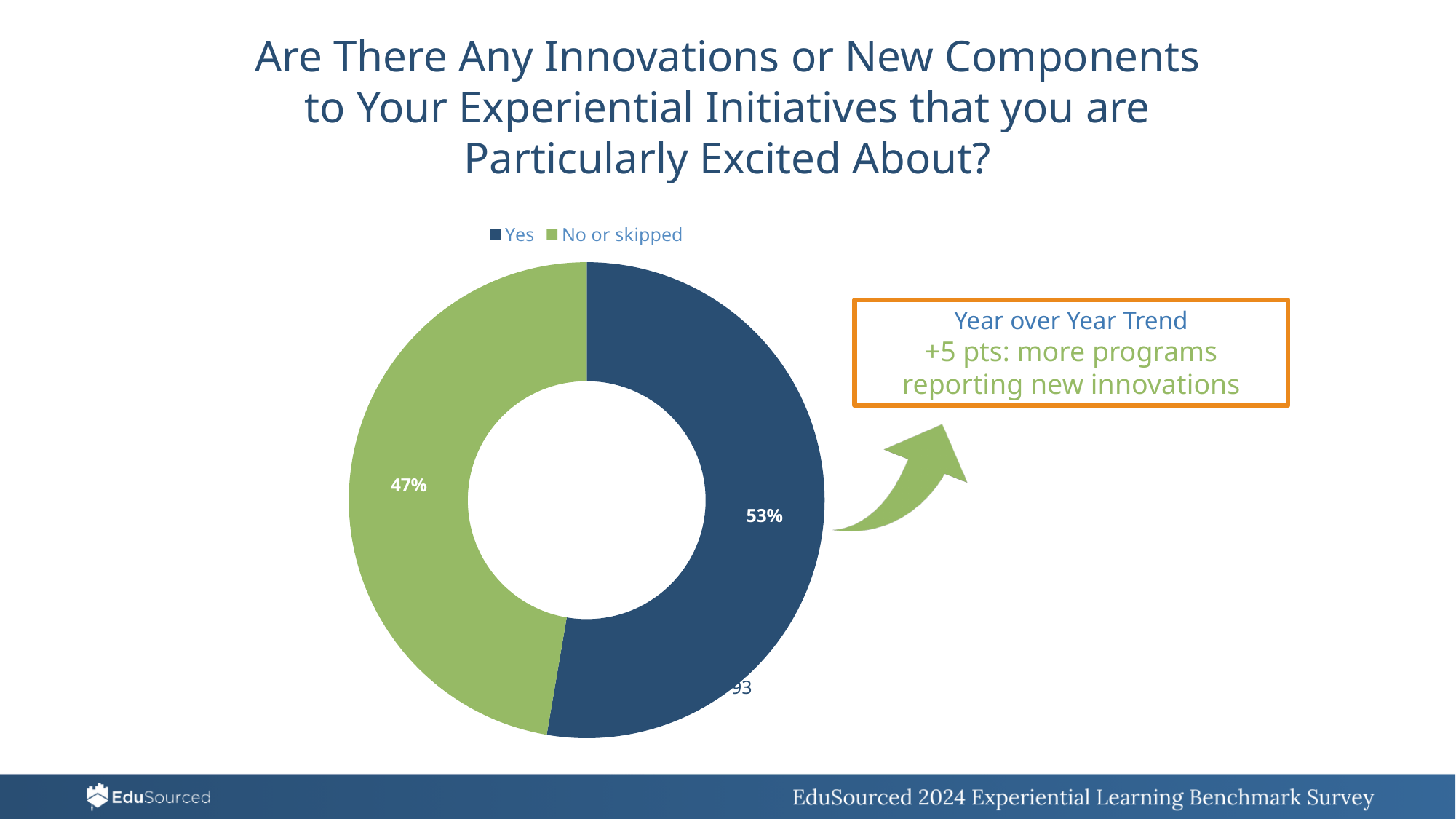
Which category has the larger share, Yes or No or skipped? Yes Which category has the smallest share of the chart? No or skipped What percentage of respondents answered No or skipped? 47% What kind of chart is shown on the slide? Doughnut (pie) chart How many entries does the legend list? 2 According to the callout box, what is the year over year trend for programs reporting new innovations? +5 pts What is the difference in percentage points between the Yes and No or skipped shares? 6 percentage points How many categories does the chart show? 2 What colour represents the Yes category? Dark blue What percentage of respondents answered Yes? 53%